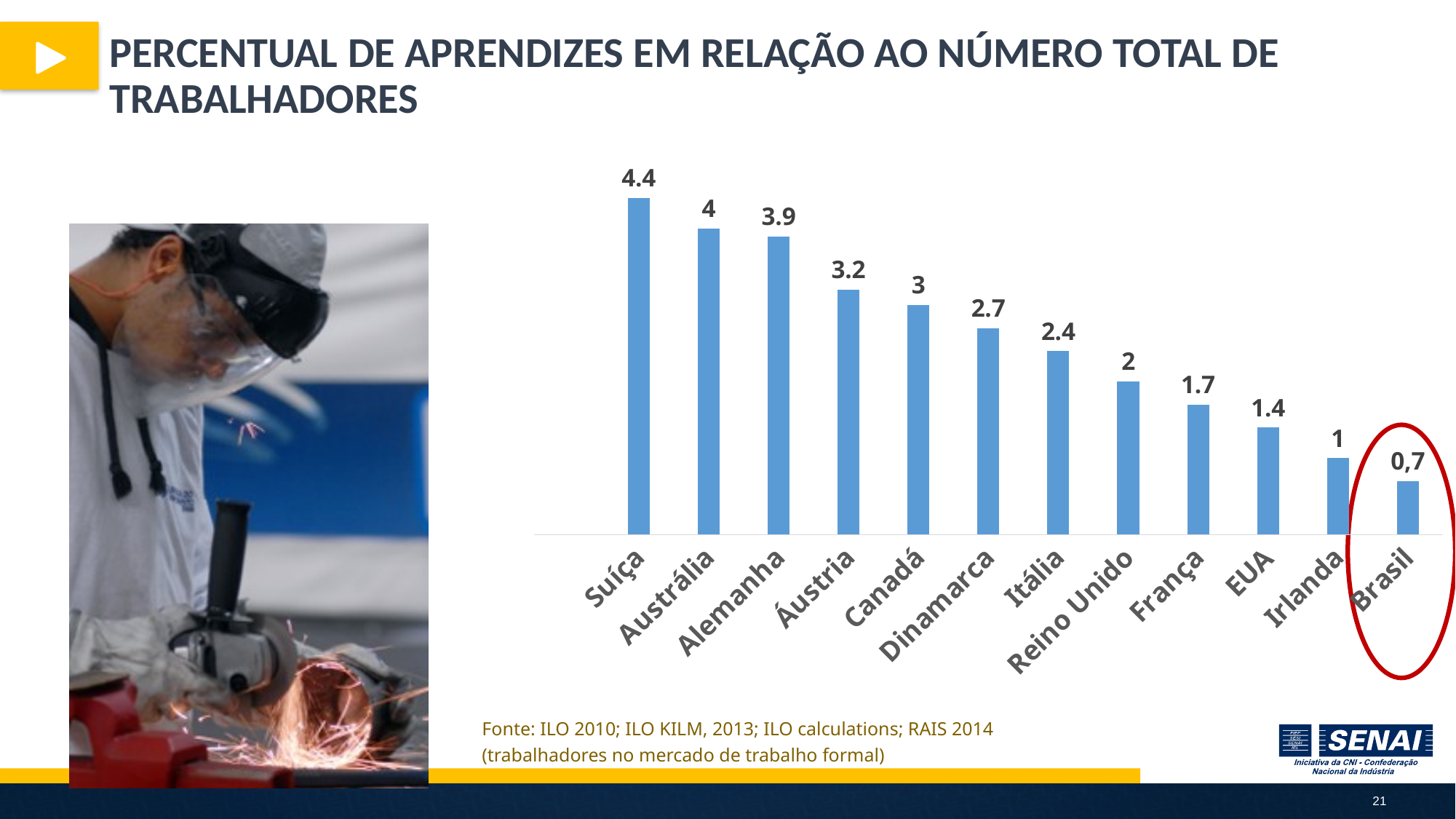
What is the value for Suíça? 4.4 What is the difference between the values for Suíça and Brasil? 3.7 How many countries are shown in the chart? 12 Which country has the lowest value? Brasil What is the value for Reino Unido? 2 Which is larger, the value for Itália or the value for França? Itália What kind of chart is shown on the slide? Bar chart Do the values rise or fall from left to right along the x axis? Fall What is the value for Dinamarca? 2.7 Which country has the highest value? Suíça What is the value for Brasil? 0,7 What is the difference between the values for Alemanha and Áustria? 0.7